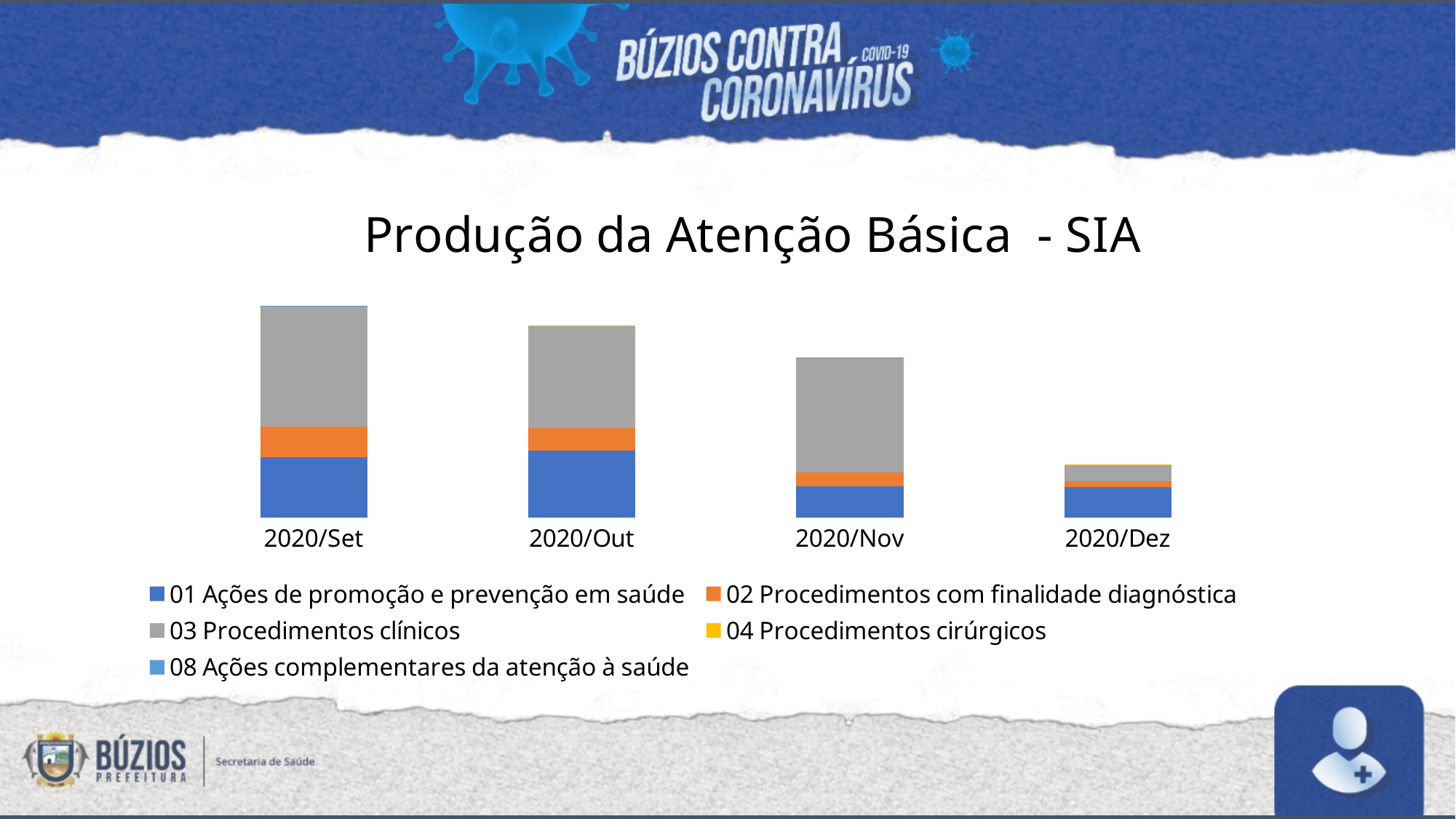
What is the title of the chart? Produção da Atenção Básica - SIA Which month has the larger blue '01 Ações de promoção e prevenção em saúde' segment, 2020/Out or 2020/Nov? 2020/Out How many months (categories) are shown on the x axis? 4 How many series does the legend list? 5 Which series occupies the largest portion of the 2020/Nov bar? 03 Procedimentos clínicos Which month has the smaller grey '03 Procedimentos clínicos' segment, 2020/Set or 2020/Dez? 2020/Dez Which series is shown in grey in the legend? 03 Procedimentos clínicos Which month has the tallest stacked bar? 2020/Set Which month has the shortest stacked bar? 2020/Dez Do the total bar heights rise or fall from 2020/Set to 2020/Dez? Fall What kind of chart is shown on the slide? Stacked bar chart